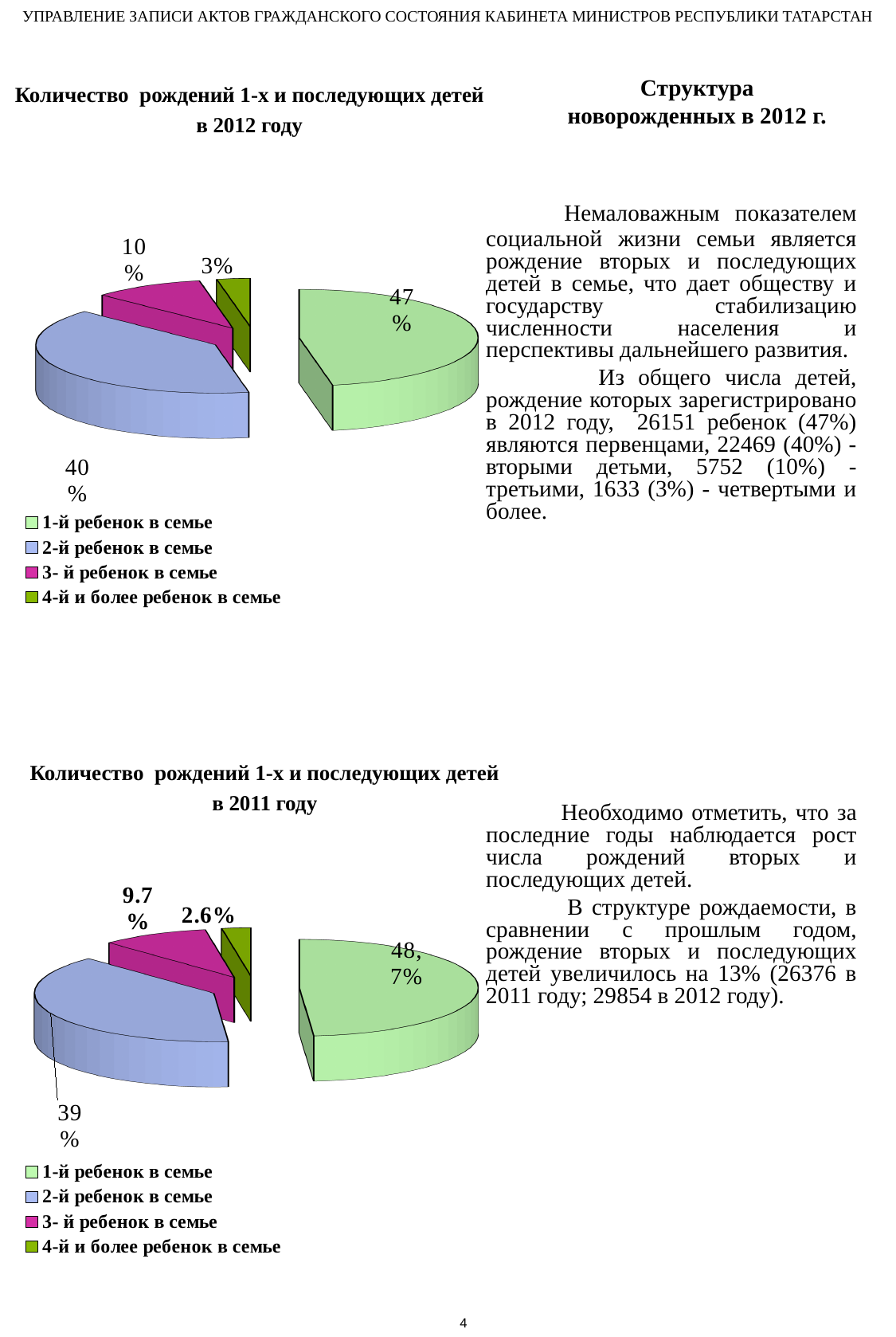
How many categories does the legend of the chart 'Количество рождений 1-х и последующих детей в 2012 году' list? 4 In the chart 'Количество рождений 1-х и последующих детей в 2012 году', what is the difference between the shares for '1-й ребенок в семье' and '2-й ребенок в семье'? 7% What type of chart is 'Количество рождений 1-х и последующих детей в 2011 году'? Pie chart In the chart 'Количество рождений 1-х и последующих детей в 2012 году', what share is shown for '2-й ребенок в семье'? 40% In the chart 'Количество рождений 1-х и последующих детей в 2012 году', what share is shown for '1-й ребенок в семье'? 47% In the chart 'Количество рождений 1-х и последующих детей в 2011 году', what share is shown for '4-й и более ребенок в семье'? 2.6% In the chart 'Количество рождений 1-х и последующих детей в 2012 году', which category has the largest slice? 1-й ребенок в семье In the chart 'Количество рождений 1-х и последующих детей в 2012 году', what share is shown for '4-й и более ребенок в семье'? 3% In the chart 'Количество рождений 1-х и последующих детей в 2011 году', what share is shown for '2-й ребенок в семье'? 39% In the chart 'Количество рождений 1-х и последующих детей в 2011 году', which is larger: the share for '3- й ребенок в семье' or for '4-й и более ребенок в семье'? 3- й ребенок в семье In the chart 'Количество рождений 1-х и последующих детей в 2012 году', which category has the smallest slice? 4-й и более ребенок в семье In the chart 'Количество рождений 1-х и последующих детей в 2011 году', what share is shown for '3- й ребенок в семье'? 9.7%